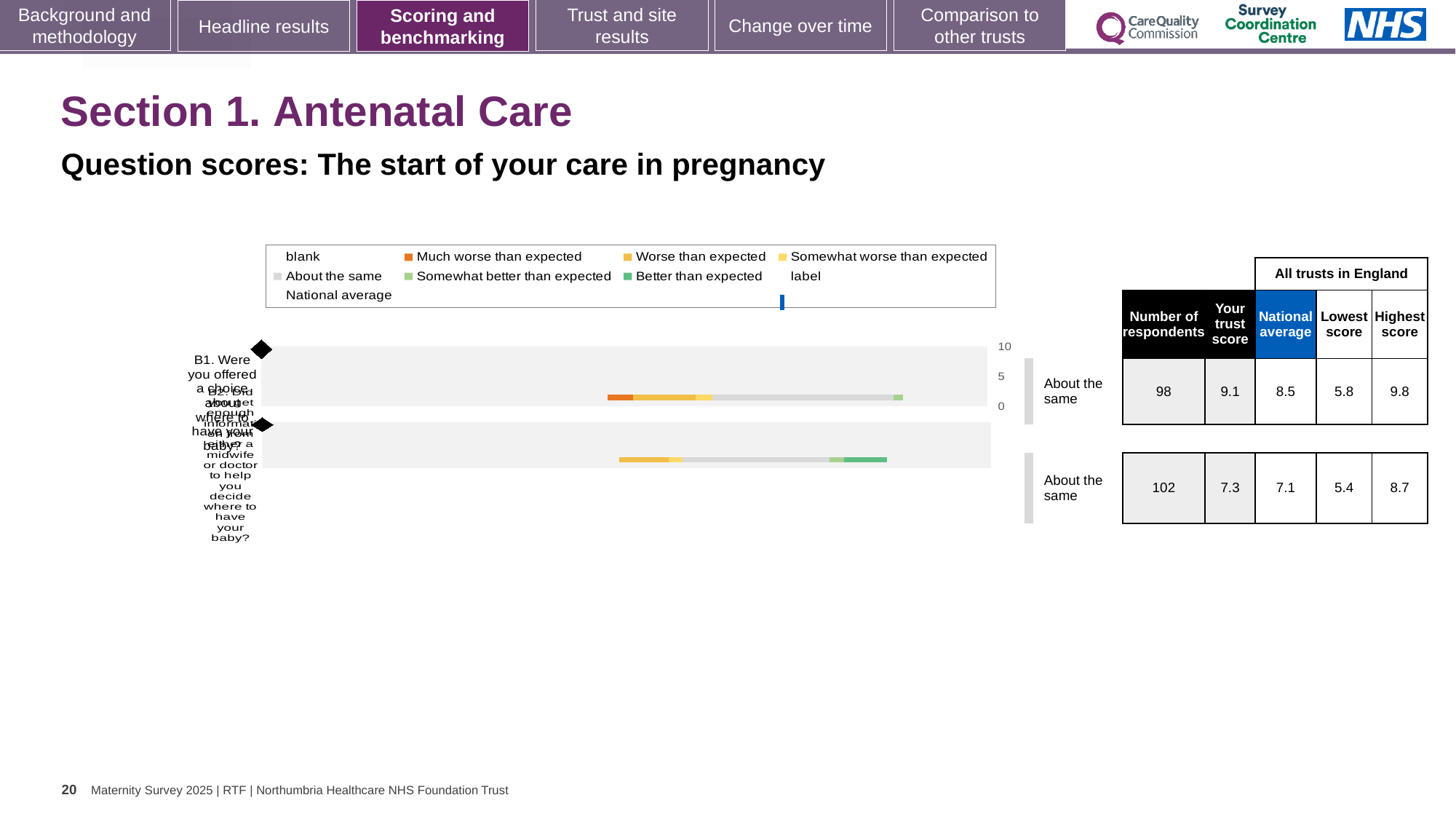
What is the trust score for question B2 (Did you get enough information from either a midwife or doctor to help you decide where to have your baby?)? 7.3 What is the difference between the highest score and the lowest score for question B2? 3.3 By how much does the trust score for B1 exceed the national average for B1? 0.6 What kind of chart is shown on the slide? bar chart What is the national average score for question B1? 8.5 How many survey questions (bars) are plotted on the chart? 2 What colour represents 'Much worse than expected' in the chart legend? orange What is the highest value shown on the chart's score axis? 10 Which question has the higher trust score, B1 or B2? B1 How many respondents answered question B2? 102 What is the trust score for question B1 (Were you offered a choice about where to have your baby?)? 9.1